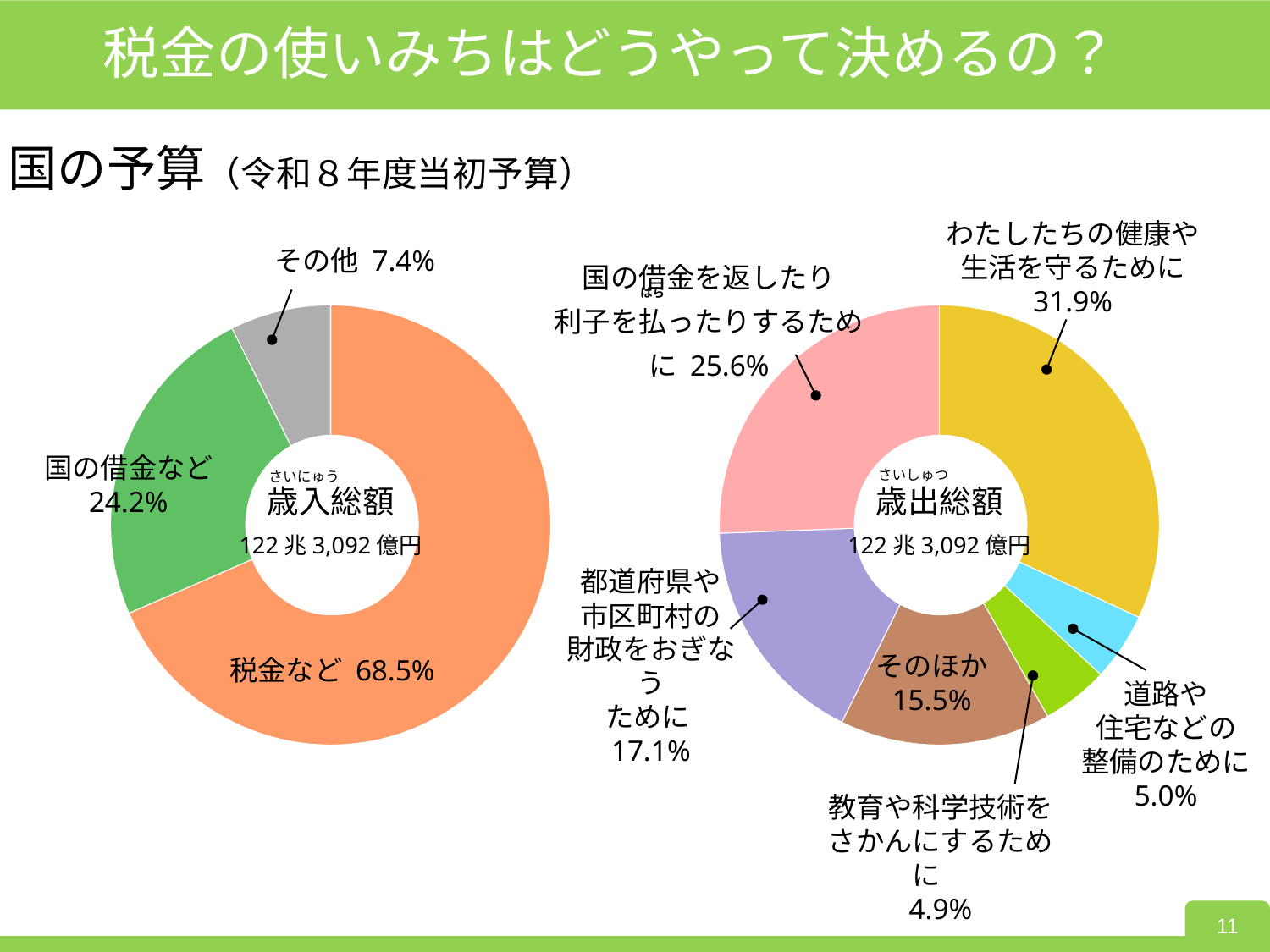
左の「歳入総額」のグラフで、「国の借金など」の割合は何%ですか？ 24.2% 左の「歳入総額」のグラフには、いくつの項目がありますか？ 3 右の「歳出総額」のグラフで、最も割合が大きい項目は何ですか？ わたしたちの健康や生活を守るために 右の「歳出総額」のグラフで、「わたしたちの健康や生活を守るために」の割合は何%ですか？ 31.9% 左の「歳入総額」のグラフで、「税金など」と「国の借金など」の割合の差は何ポイントですか？ 44.3 左の「歳入総額」のグラフで、「税金など」の割合は何%ですか？ 68.5% 右の「歳出総額」のグラフには、いくつの項目がありますか？ 6 右の「歳出総額」のグラフで、「都道府県や市区町村の財政をおぎなうために」と「そのほか」では、どちらの割合が大きいですか？ 都道府県や市区町村の財政をおぎなうために このスライドのグラフはどのような種類のグラフですか？ 円グラフ（ドーナツグラフ） 左の「歳入総額」のグラフで、最も割合が小さい項目は何ですか？ その他 右の「歳出総額」のグラフで、「教育や科学技術をさかんにするために」の割合は何%ですか？ 4.9% 右の「歳出総額」のグラフで、「国の借金を返したり利子を払ったりするために」と「道路や住宅などの整備のために」の割合の差は何ポイントですか？ 20.6